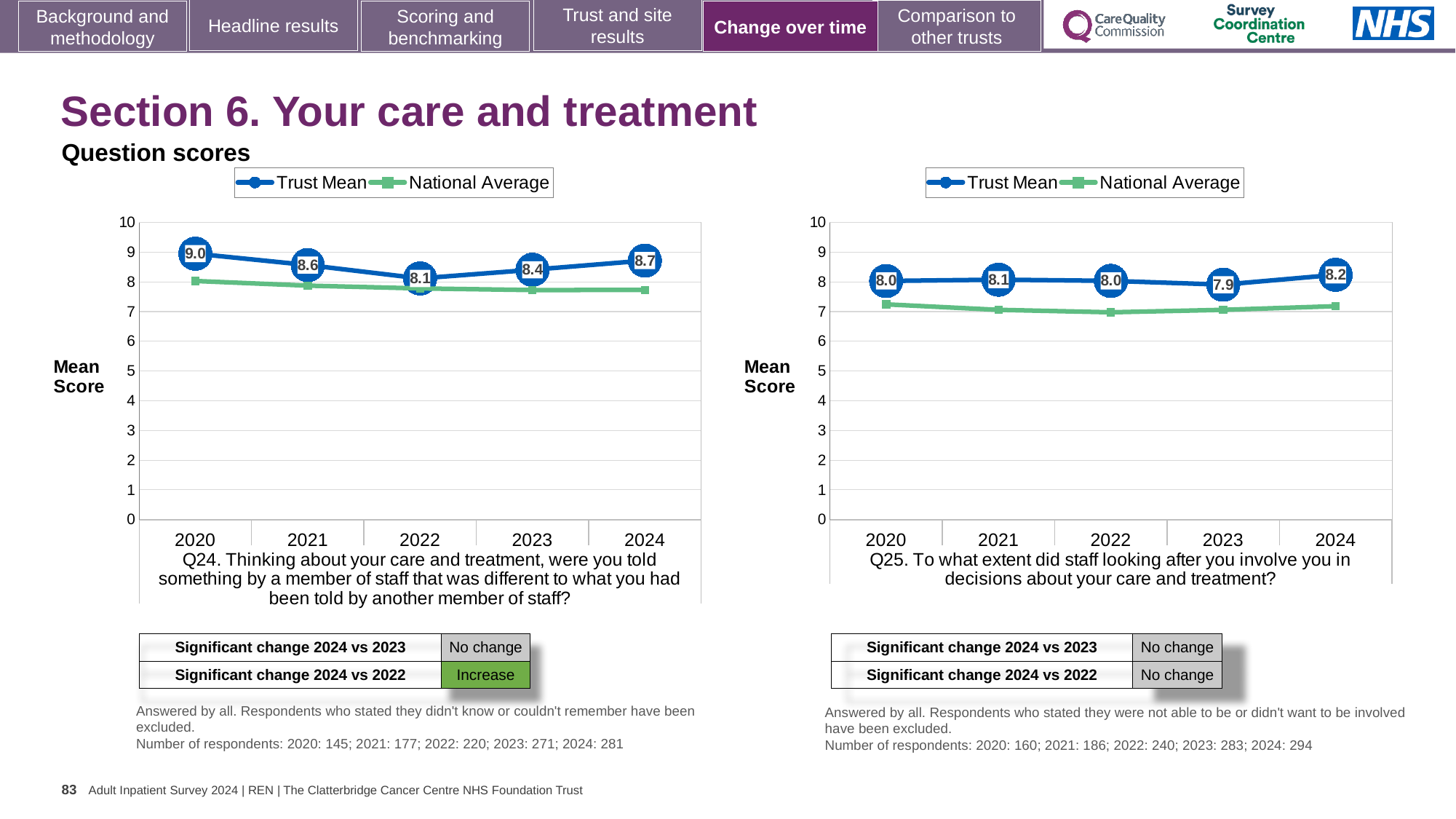
In the Q24 chart on the left, what is the Trust Mean score for 2020? 9.0 In the Q24 chart on the left, which year has the highest Trust Mean score? 2020 In the Q25 chart on the right, what is the Trust Mean score for 2023? 7.9 In the Q24 chart on the left, which year has the lowest Trust Mean score? 2022 In the Q25 chart on the right, what is the Trust Mean score for 2024? 8.2 In the Q25 chart on the right, which year has the lowest Trust Mean score? 2023 How many years are plotted on the x axis of the Q24 chart on the left? 5 In the Q25 chart on the right, is the National Average for 2022 greater or less than 8? less In the Q24 chart on the left, what is the difference between the Trust Mean scores for 2020 and 2022? 0.9 In the Q24 chart on the left, what is the Trust Mean score for 2022? 8.1 How many series does the legend of the Q25 chart on the right list? 2 In the Q25 chart on the right, is the Trust Mean for 2024 higher or lower than the Trust Mean for 2023? higher